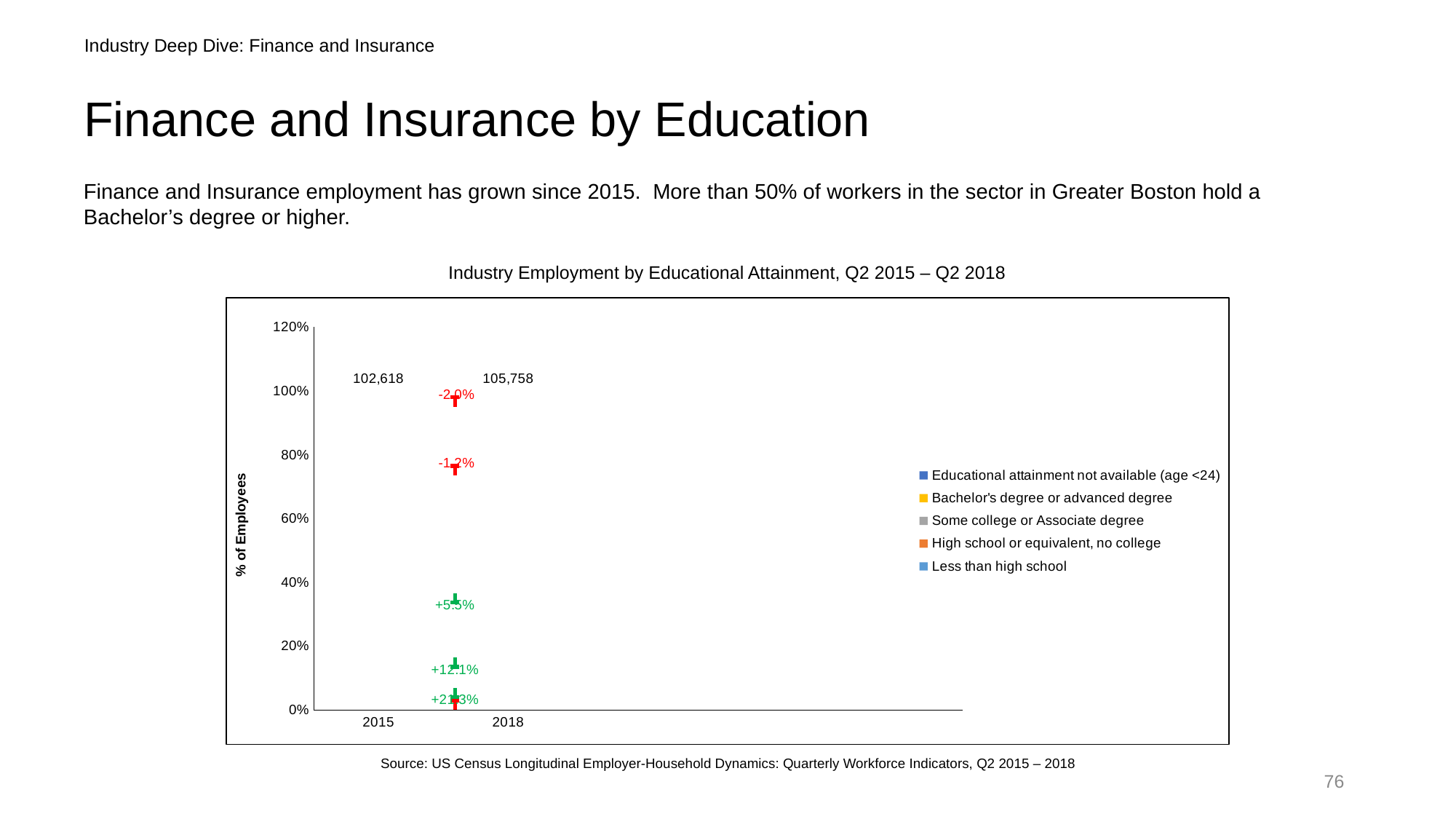
What is the label on the y axis of the chart? % of Employees What total employment figure is printed above the 2018 bar in the Industry Employment by Educational Attainment chart? 105,758 By how much does the printed 2018 total employment (105,758) exceed the printed 2015 total (102,618)? 3,140 How many years (categories) are shown on the x axis of the chart? 2 How many series does the legend of the chart list? 5 What total employment figure is printed above the 2015 bar in the Industry Employment by Educational Attainment chart? 102,618 Is the 2015 total employment figure printed on the chart greater or less than 100,000? greater Does the total employment figure printed on the chart rise or fall from 2015 to 2018? rise What is the largest percentage change label printed between the two bars on the chart? +21.3% What is the most negative percentage change label printed between the two bars on the chart? -2.0% What is the title of the chart on the slide? Industry Employment by Educational Attainment, Q2 2015 – Q2 2018 Which year has the larger total employment figure printed on the chart, 2015 or 2018? 2018